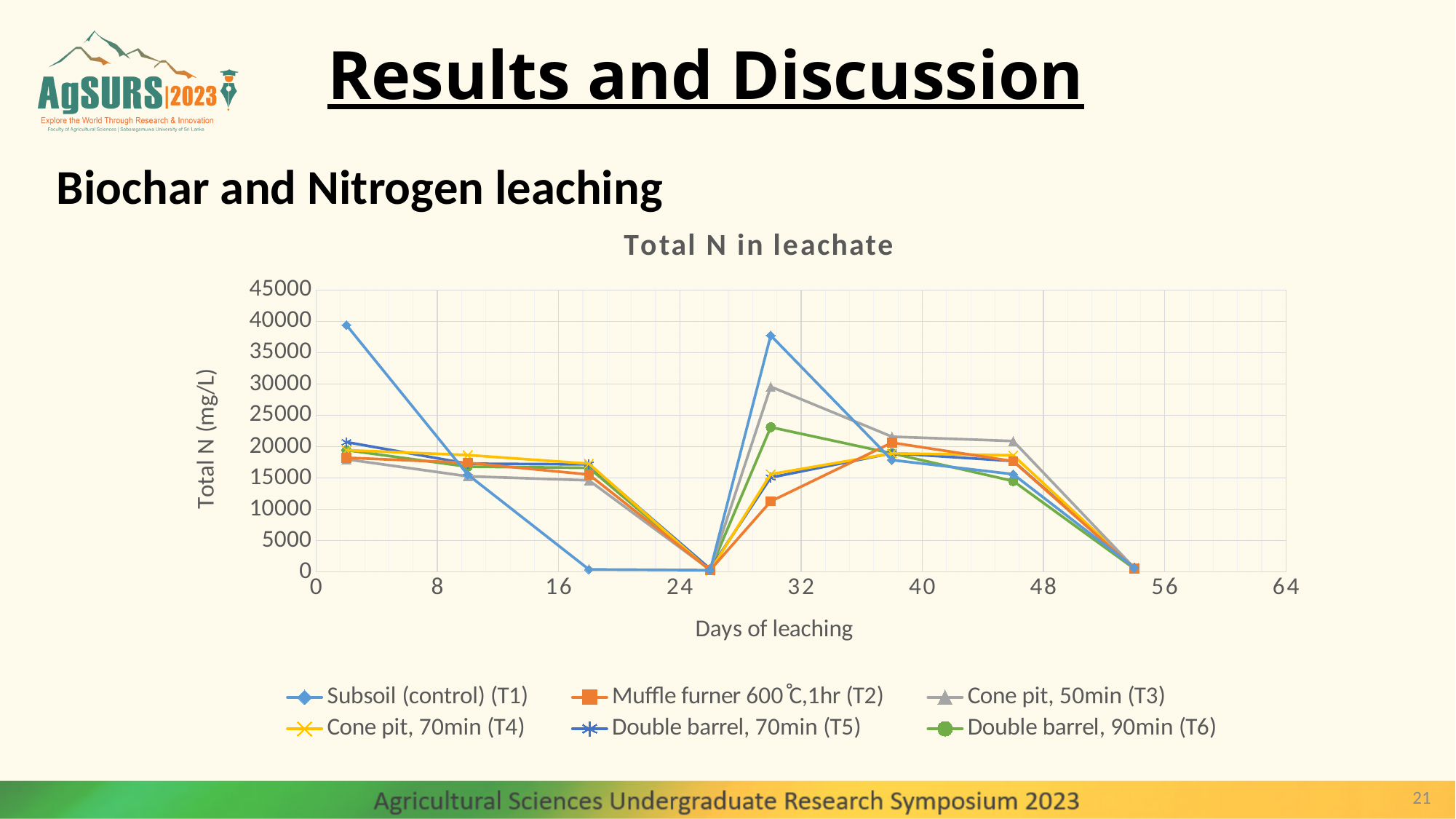
How many series does the legend list? 6 What is the label of the y axis? Total N (mg/L) What kind of chart is shown on the slide? line chart At the point around day 30, which is larger: Cone pit, 50min (T3) or Double barrel, 90min (T6)? Cone pit, 50min (T3) Which series reaches the highest value at the peak around day 30? Subsoil (control) (T1) Is the value for Subsoil (control) (T1) at the first time point greater or less than 35000? greater How many time points are plotted for each series? 8 Is the value for Subsoil (control) (T1) at the last time point greater or less than 5000? less What is the title of the chart? Total N in leachate Is the value for Muffle furner 600°C,1hr (T2) at the point around day 30 greater or less than 15000? less Which series has the highest value at the first time point (around day 2)? Subsoil (control) (T1) Do the values for all series rise or fall between the point around day 46 and the last point around day 54? fall